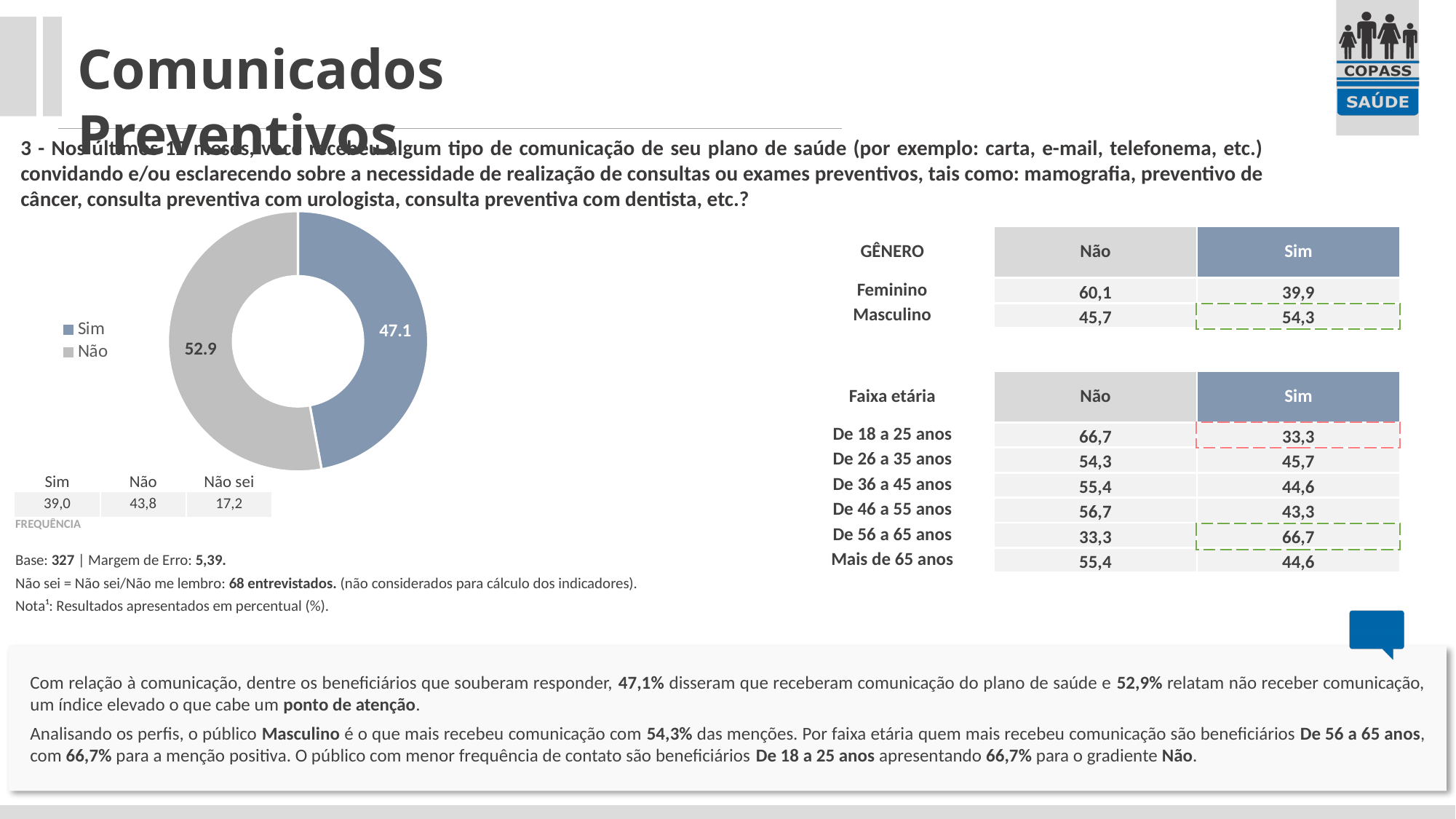
Which slice of the donut chart is the smallest? Sim How many entries does the legend of the donut chart list? 2 What value is shown for the "Sim" slice of the donut chart? 47.1 What share of the donut chart does the "Sim" slice represent? 47.1 What is the difference between the "Não" and "Sim" values in the donut chart? 5.8 Which colour represents "Não" in the donut chart? Grey Which slice of the donut chart is the largest? Não What value is shown for the "Não" slice of the donut chart? 52.9 In the donut chart, is the value for "Sim" larger or smaller than the value for "Não"? smaller Which colour represents "Sim" in the donut chart? Blue What kind of chart is shown on the slide? Donut (pie) chart How many slices does the donut chart have? 2